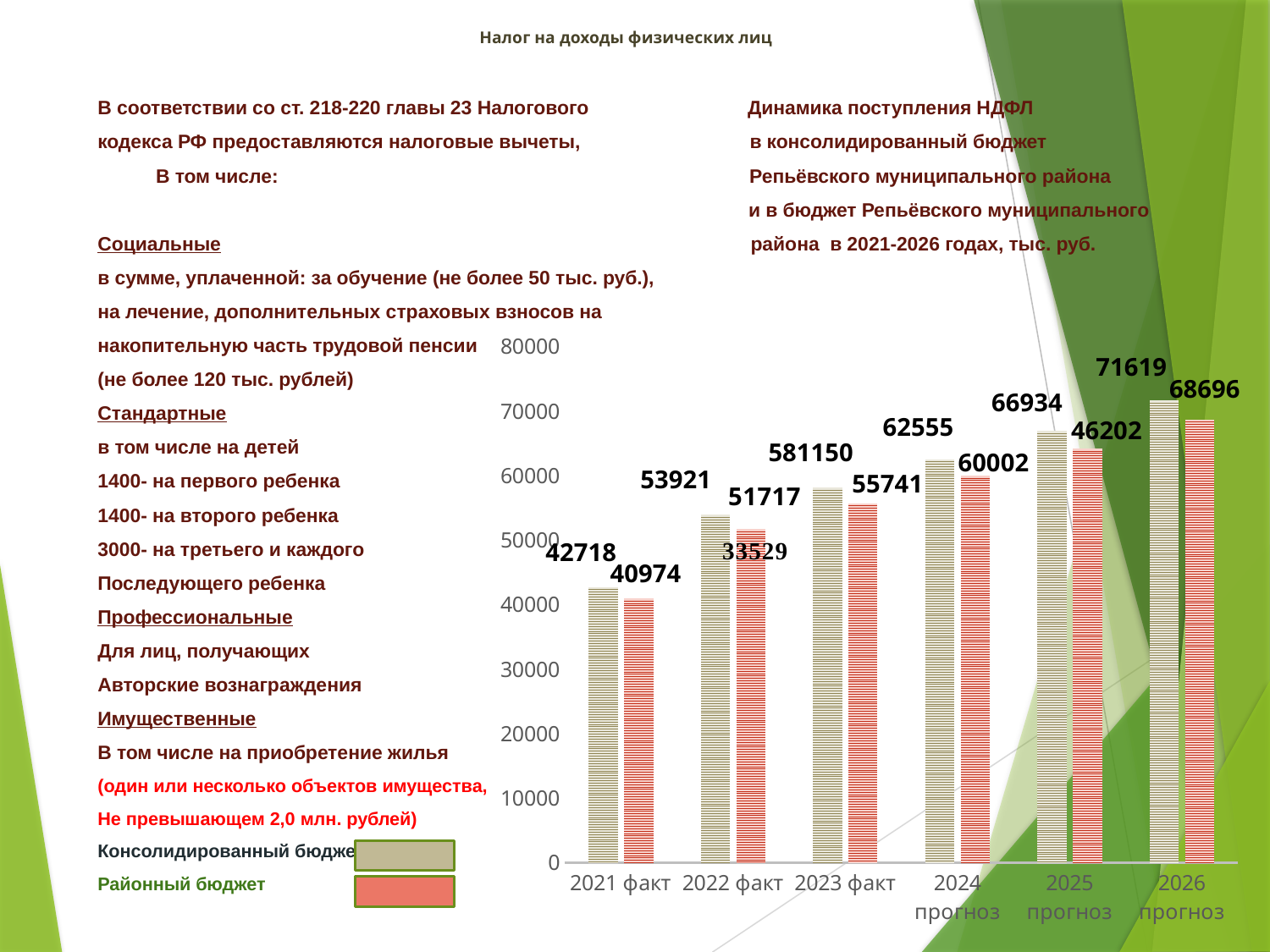
In which year is the Консолидированный бюджет value the highest? 2026 прогноз What is the value of the Районный бюджет series for 2021 факт? 40974 Do the Консолидированный бюджет values rise or fall from 2021 to 2026? rise What is the value of the Консолидированный бюджет series for 2026 прогноз? 71619 What is the value of the Консолидированный бюджет series for 2021 факт? 42718 What is the difference between the Консолидированный бюджет and Районный бюджет values for 2026 прогноз? 2923 What is the value of the Районный бюджет series for 2024 прогноз? 60002 How many series does the chart show? 2 How many years (categories) are shown on the x axis? 6 What is the value of the Районный бюджет series for 2026 прогноз? 68696 In which year is the Консолидированный бюджет value the lowest? 2021 факт What kind of chart is shown on the slide? bar chart